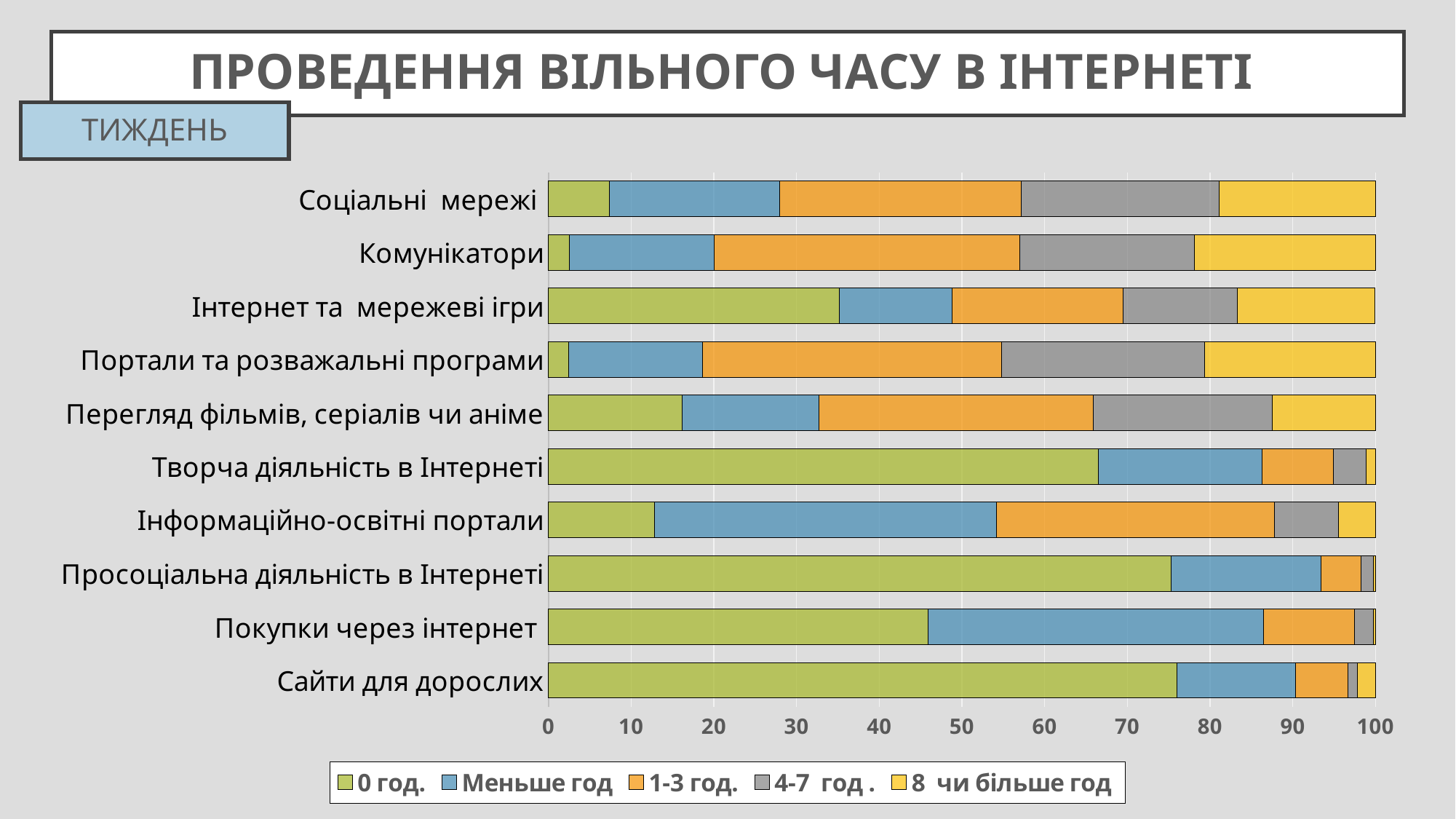
Which has the larger '0 год.' segment: 'Творча діяльність в Інтернеті' or 'Інформаційно-освітні портали'? Творча діяльність в Інтернеті Is the value of the '0 год.' segment for 'Покупки через інтернет' greater or less than 50? less Which legend entry is shown in yellow? 8 чи більше год Is the value of the '0 год.' segment for 'Творча діяльність в Інтернеті' greater or less than 60? greater Is the value of the '0 год.' segment for 'Інтернет та мережеві ігри' greater or less than 30? greater What is the title of the slide above the chart? ПРОВЕДЕННЯ ВІЛЬНОГО ЧАСУ В ІНТЕРНЕТІ Which has the larger '0 год.' segment: 'Соціальні мережі' or 'Перегляд фільмів, серіалів чи аніме'? Перегляд фільмів, серіалів чи аніме What kind of chart is shown on the slide? Stacked bar chart How many categories (activities) are plotted on the chart? 10 How many series does the legend list? 5